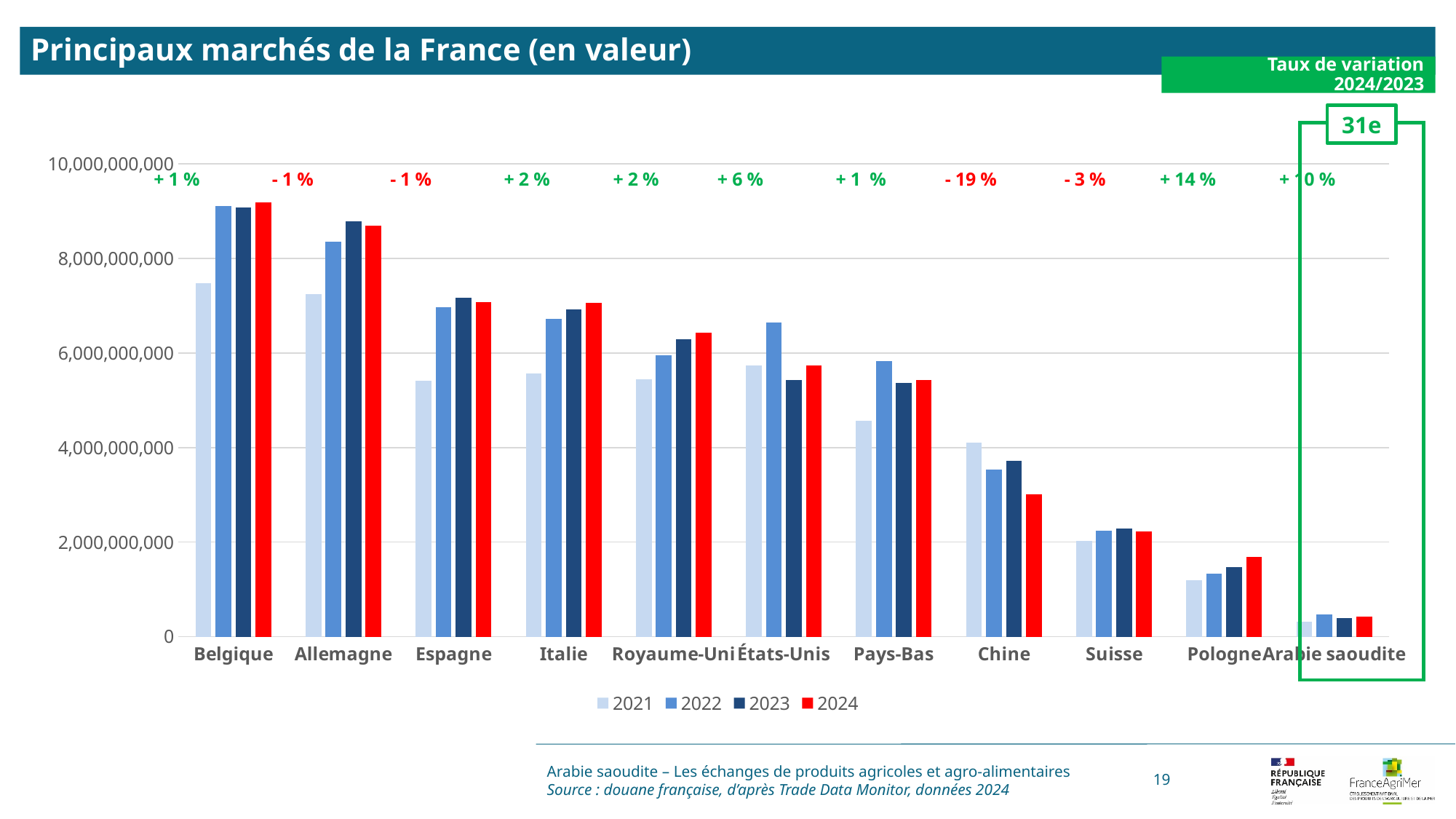
Do the values for Pologne rise or fall from 2021 to 2024? rise Is the 2024 value for Belgique greater or less than 8,000,000,000? greater What kind of chart is shown on the slide? bar chart Which is larger for Chine: the 2021 value or the 2024 value? 2021 Is the 2022 value for États-Unis greater or less than 6,000,000,000? greater What is the title of the chart? Principaux marchés de la France (en valeur) How many countries are shown on the x axis? 11 How many series does the legend list? 4 Which country has the lowest value for 2024? Arabie saoudite Which country has the highest value for 2024? Belgique What 2024/2023 variation rate is shown above Chine? - 19 % Is the 2024 value for Chine greater or less than 4,000,000,000? less